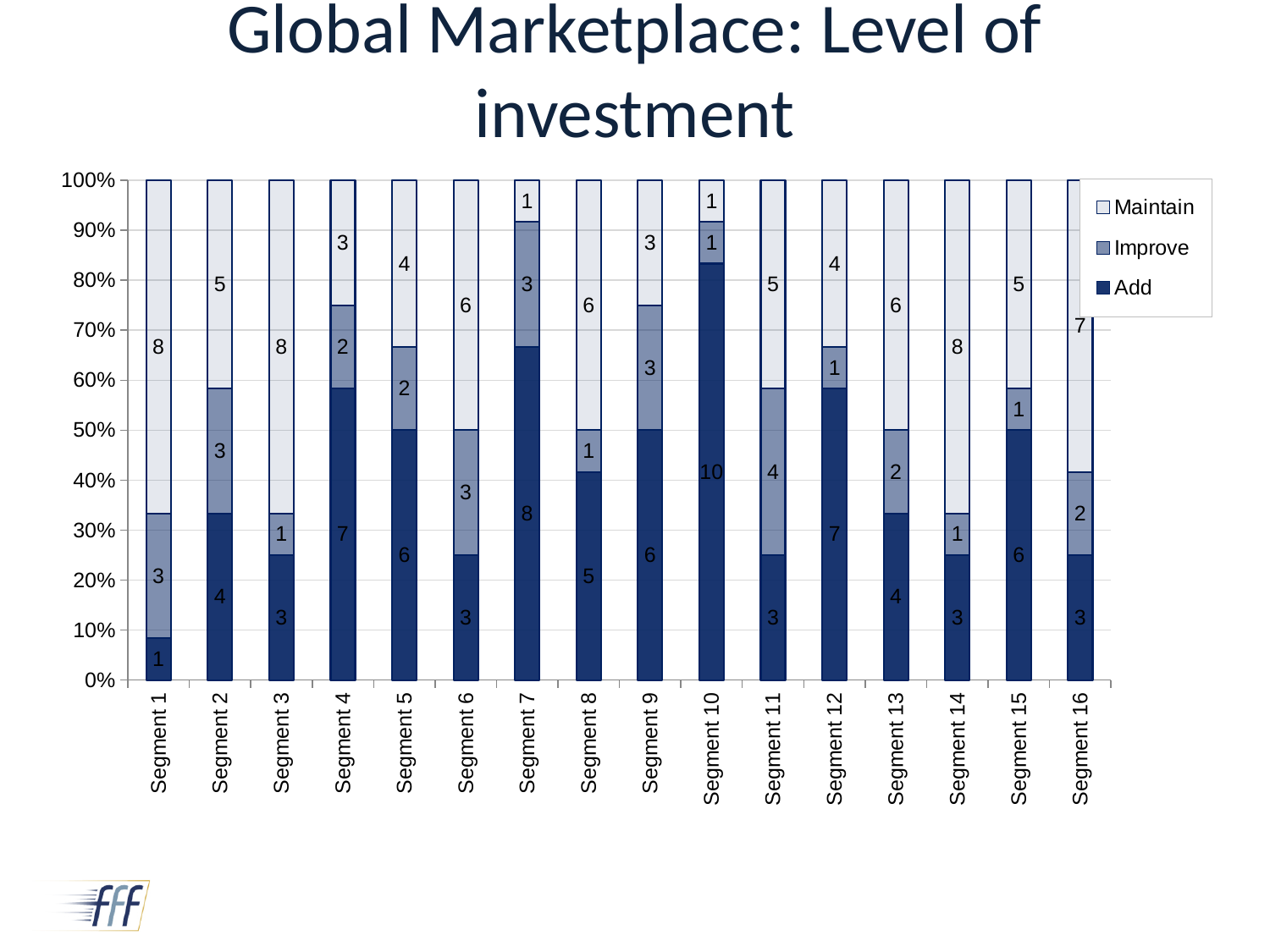
What is the total of the three values stacked in the Segment 5 bar? 12 What is the difference between the Maintain values for Segment 1 and Segment 7? 7 What is the Maintain value for Segment 3? 8 What kind of chart is shown on the slide? Stacked bar chart What is the Add value for Segment 10? 10 What is the title of the chart? Global Marketplace: Level of investment Which is larger, the Add value for Segment 4 or the Add value for Segment 2? Segment 4 Which segment has the highest Add value? Segment 10 Which segment has the lowest Add value? Segment 1 How many segments are shown on the x axis? 16 What is the Improve value for Segment 11? 4 How many series does the legend list? 3